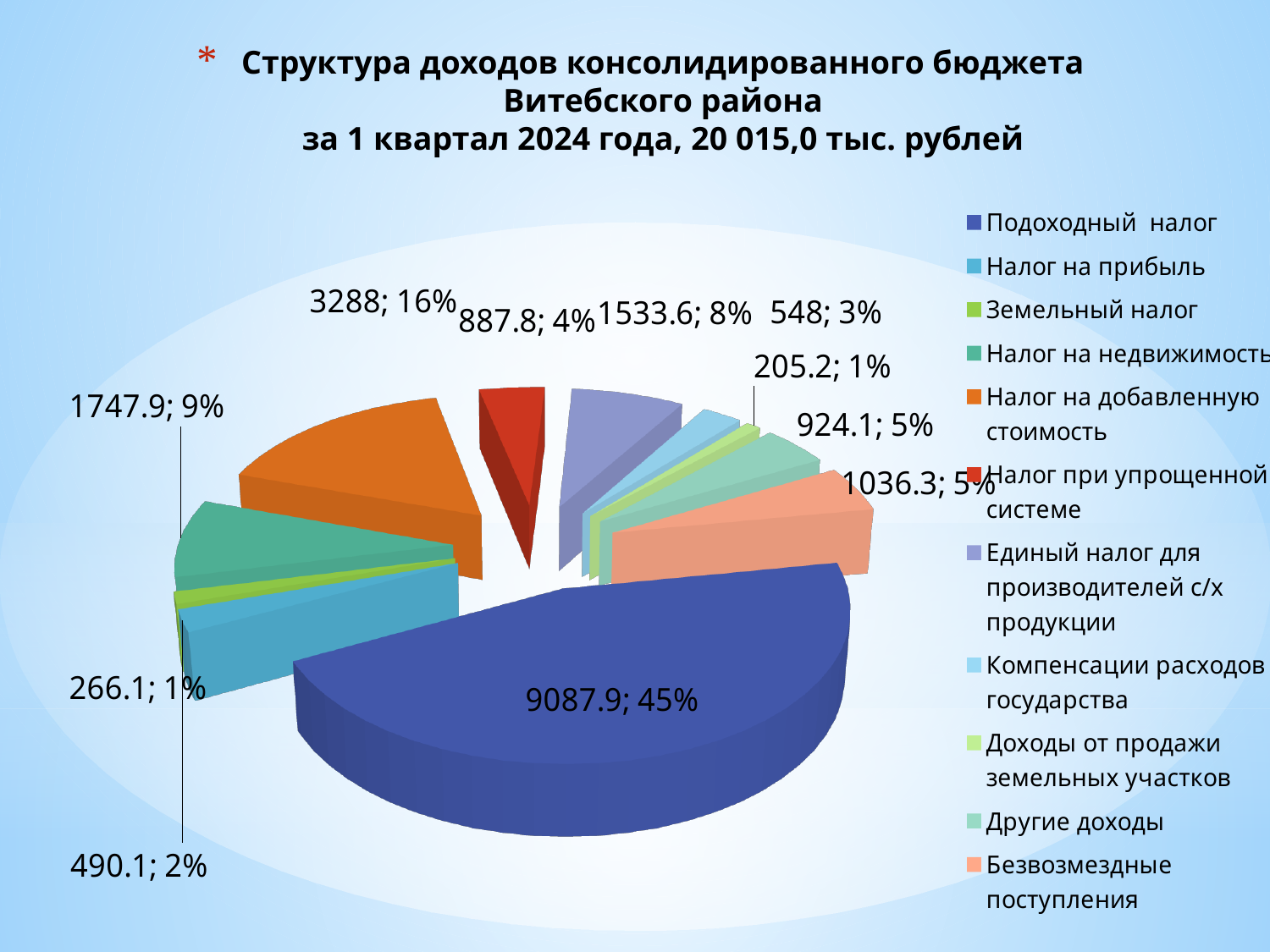
What is the smallest value printed on the pie chart? 205.2; 1% What is the difference between the value for Подоходный налог and the value for Налог на добавленную стоимость? 5799.9 What value is shown for Налог на добавленную стоимость (the orange slice)? 3288; 16% According to the chart title, what is the total consolidated budget income for the 1st quarter of 2024? 20 015,0 тыс. рублей What value and share are shown for Подоходный налог? 9087.9; 45% What kind of chart is shown on the slide? pie chart How many categories does the legend of the pie chart list? 11 What value is shown for Безвозмездные поступления (the salmon slice)? 1036.3; 5% What share of the pie does Подоходный налог take? 45% Which is larger: Налог на добавленную стоимость or Единый налог для производителей с/х продукции? Налог на добавленную стоимость Which category has the largest slice of the pie chart? Подоходный налог What value is shown for Единый налог для производителей с/х продукции (the lavender slice)? 1533.6; 8%